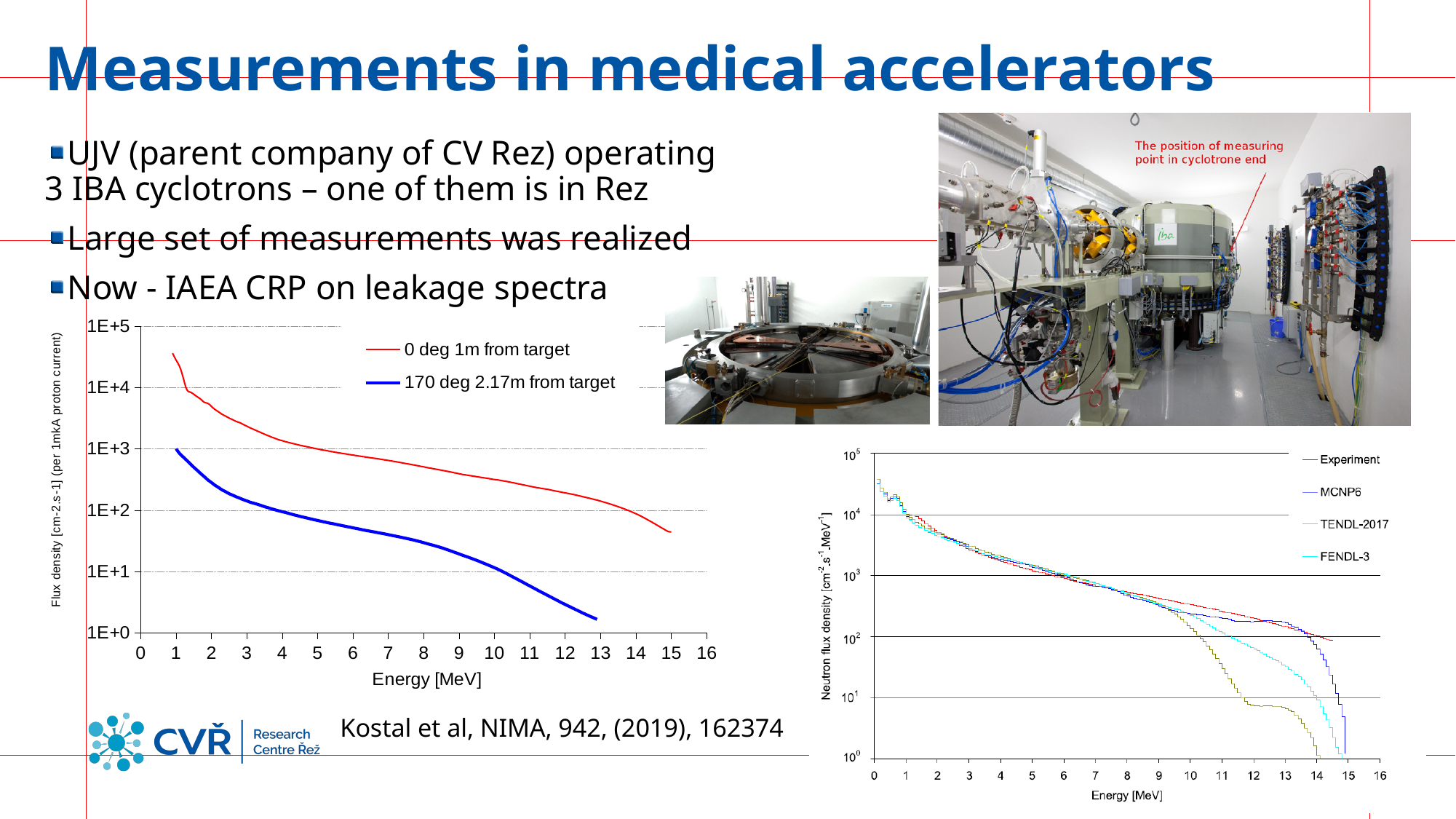
In the left chart, is the flux density of the '0 deg 1m from target' series at 10 MeV greater or less than 1E+2? greater What kind of chart is the chart on the right of the slide (neutron flux density vs energy)? line chart What are the two series named in the legend of the left chart? 0 deg 1m from target; 170 deg 2.17m from target In the left chart, which series has the higher flux density at 5 MeV? 0 deg 1m from target How many series does the legend of the left chart list? 2 In the left chart, do the flux density values rise or fall as energy increases? fall In the left chart, is the flux density of the '170 deg 2.17m from target' series at 8 MeV greater or less than 1E+2? less In the left chart, which series is drawn in blue? 170 deg 2.17m from target How many series does the legend of the right chart (neutron flux density vs energy) list? 4 What kind of chart is the chart on the left of the slide (flux density vs energy)? line chart In the left chart, is the flux density of the '0 deg 1m from target' series at 1 MeV greater or less than 1E+4? greater